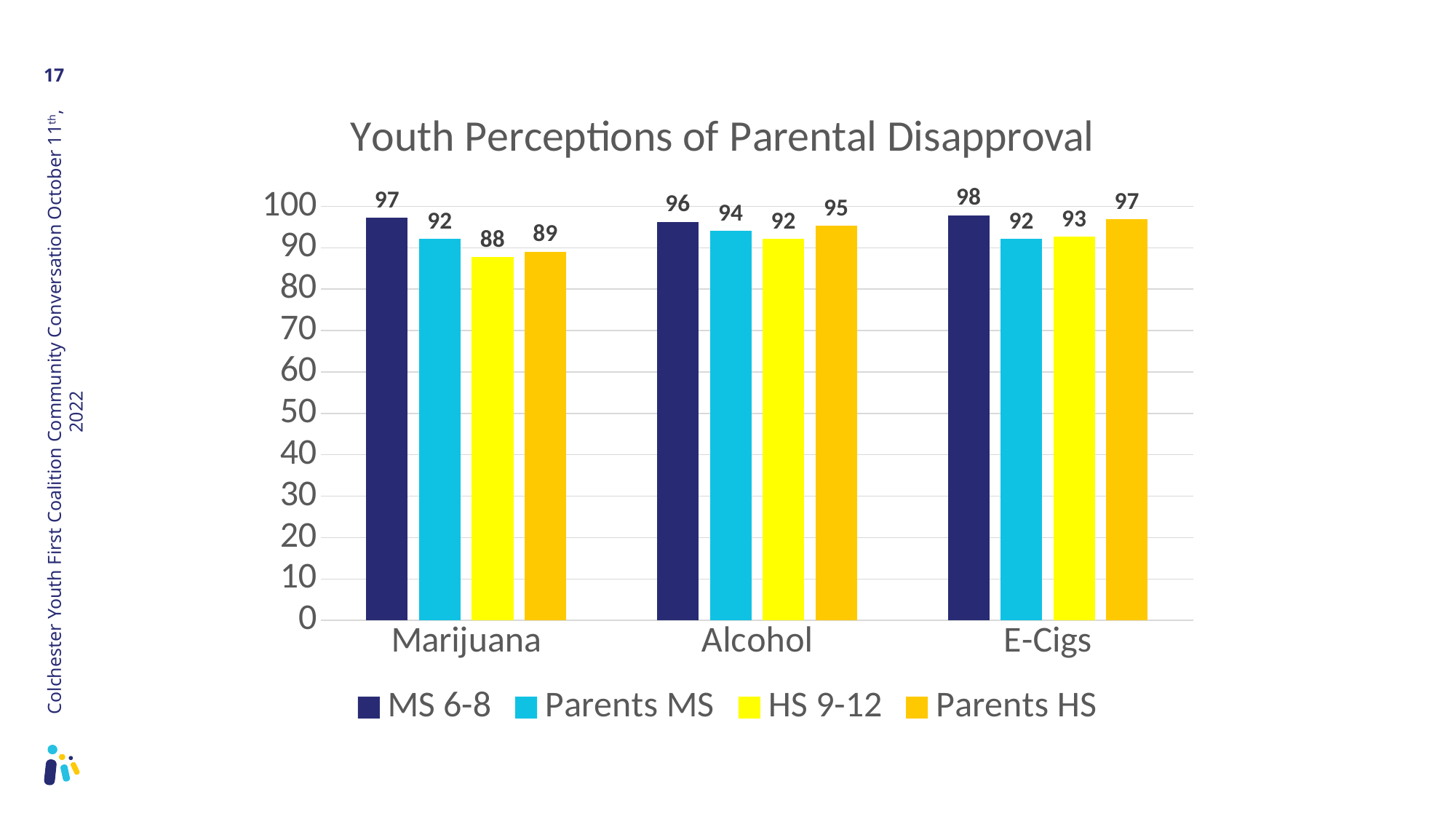
What kind of chart is shown on the slide? Bar chart What is the difference between the MS 6-8 and HS 9-12 values for Marijuana? 9 What is the value for Parents HS for Alcohol? 95 Is the value for HS 9-12 for Marijuana greater or less than 90? less What is the value for MS 6-8 for Marijuana? 97 Which category has the lowest value for the Parents HS series? Marijuana How many series does the legend list? 4 How many categories are shown on the x axis? 3 Which is larger for Alcohol: the Parents MS value or the Parents HS value? Parents HS What is the value for HS 9-12 for E-Cigs? 93 What is the title of the chart? Youth Perceptions of Parental Disapproval Which category has the highest value for the HS 9-12 series? E-Cigs